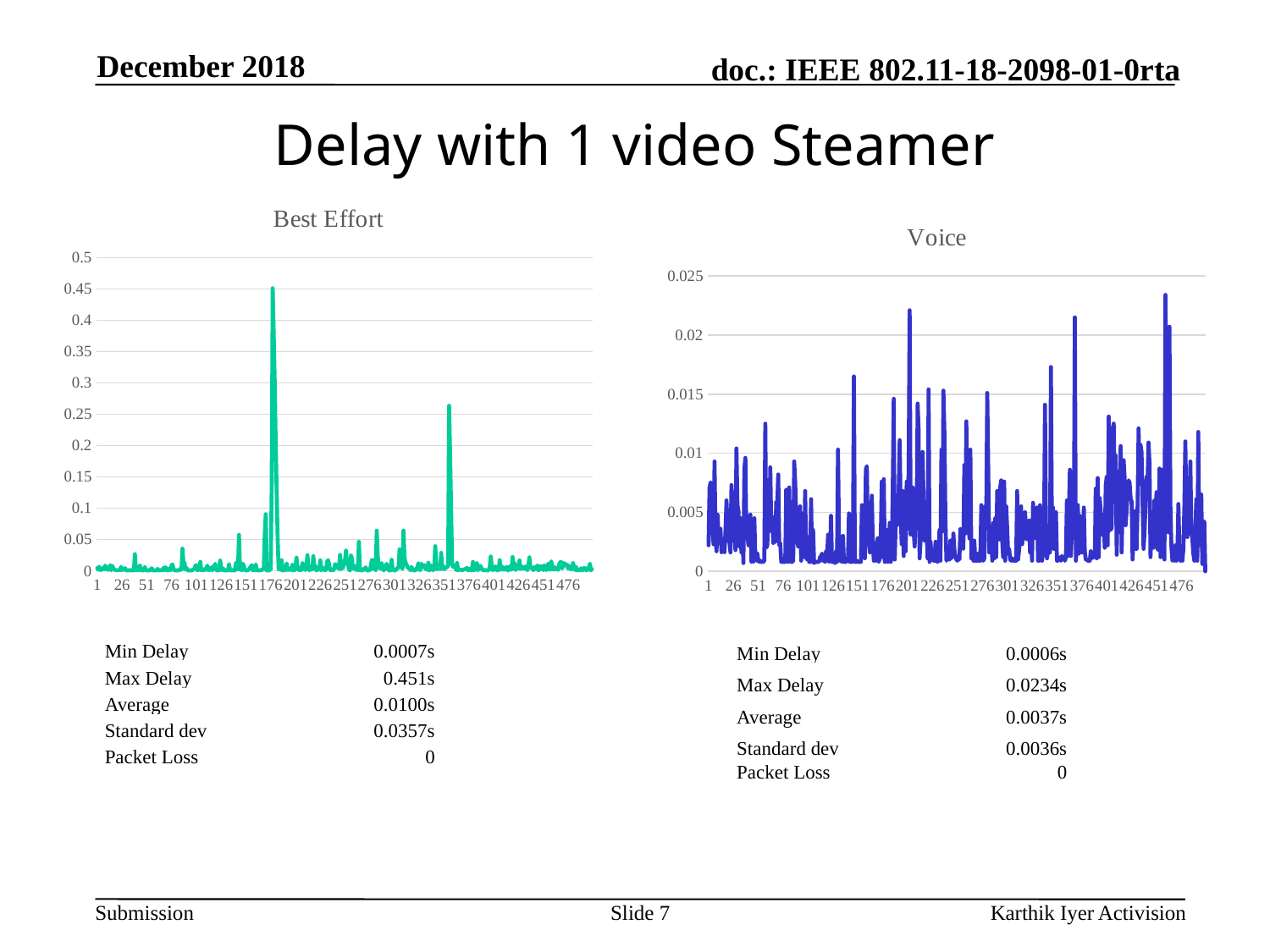
In the Best Effort chart, is the second-highest spike (near x = 351) greater or less than 0.3? less In the Best Effort chart, is the value at the first point (x = 1) greater or less than 0.05? less Which chart reaches a higher peak value, Best Effort or Voice? Best Effort What kind of chart is the Best Effort chart? line chart What kind of chart is the Voice chart? line chart In the Best Effort chart, is the highest peak greater or less than 0.4? greater What is the title of the chart on the right of the slide? Voice What is the title of the chart on the left of the slide? Best Effort